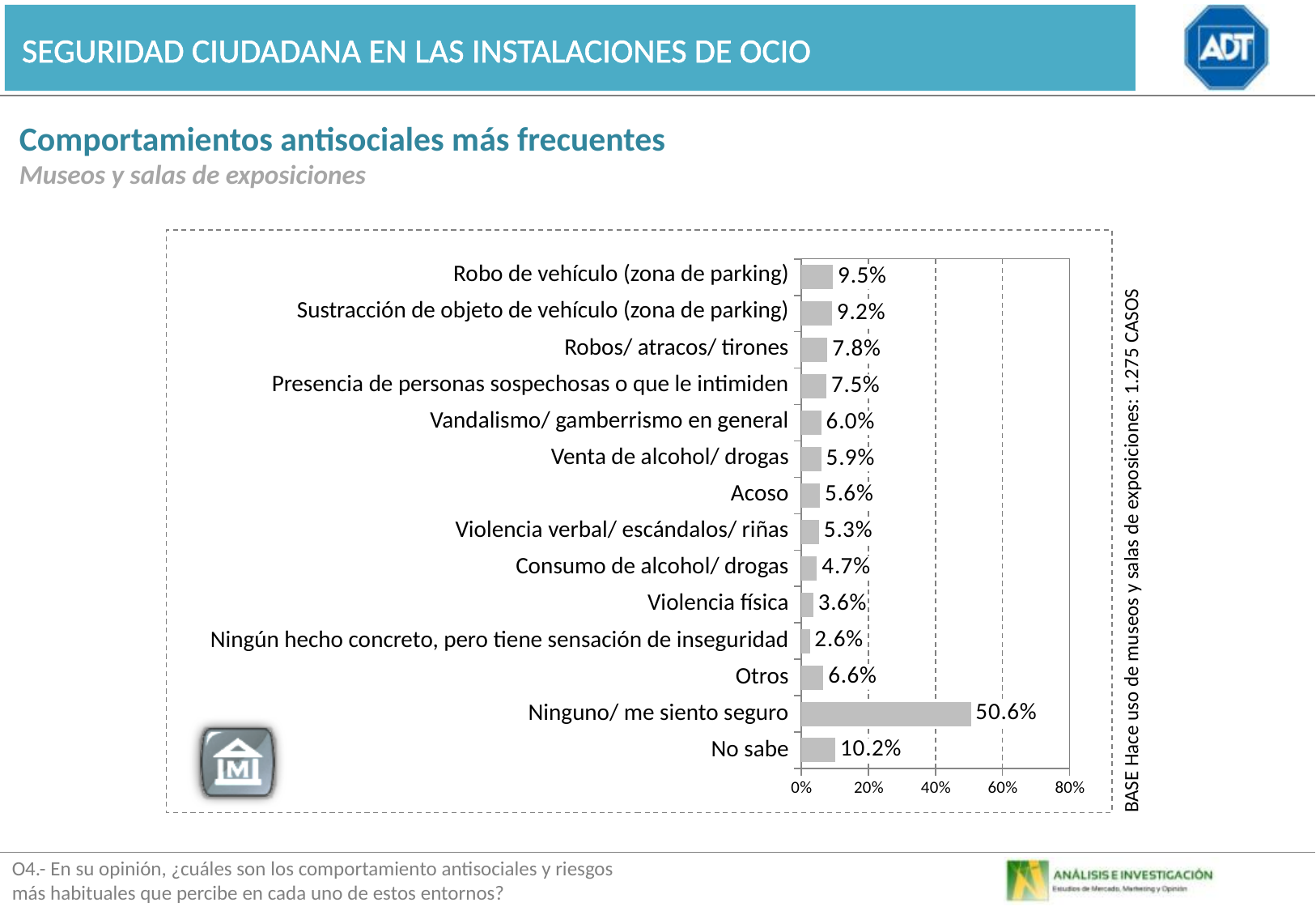
Which category has the lowest value? Ningún hecho concreto, pero tiene sensación de inseguridad Is the value for "Ninguno/ me siento seguro" greater or less than 40%? greater What is the difference between "Robo de vehículo (zona de parking)" and "Sustracción de objeto de vehículo (zona de parking)"? 0.3% What is the value for "Ninguno/ me siento seguro"? 50.6% How many categories are shown in the chart? 14 Which category has the highest value? Ninguno/ me siento seguro What is the value for "Robo de vehículo (zona de parking)"? 9.5% Which is larger, "Otros" or "Vandalismo/ gamberrismo en general"? Otros What is the value for "No sabe"? 10.2% What kind of chart is shown on the slide? bar chart What is the subtitle shown under the chart title "Comportamientos antisociales más frecuentes"? Museos y salas de exposiciones What is the value for "Violencia física"? 3.6%